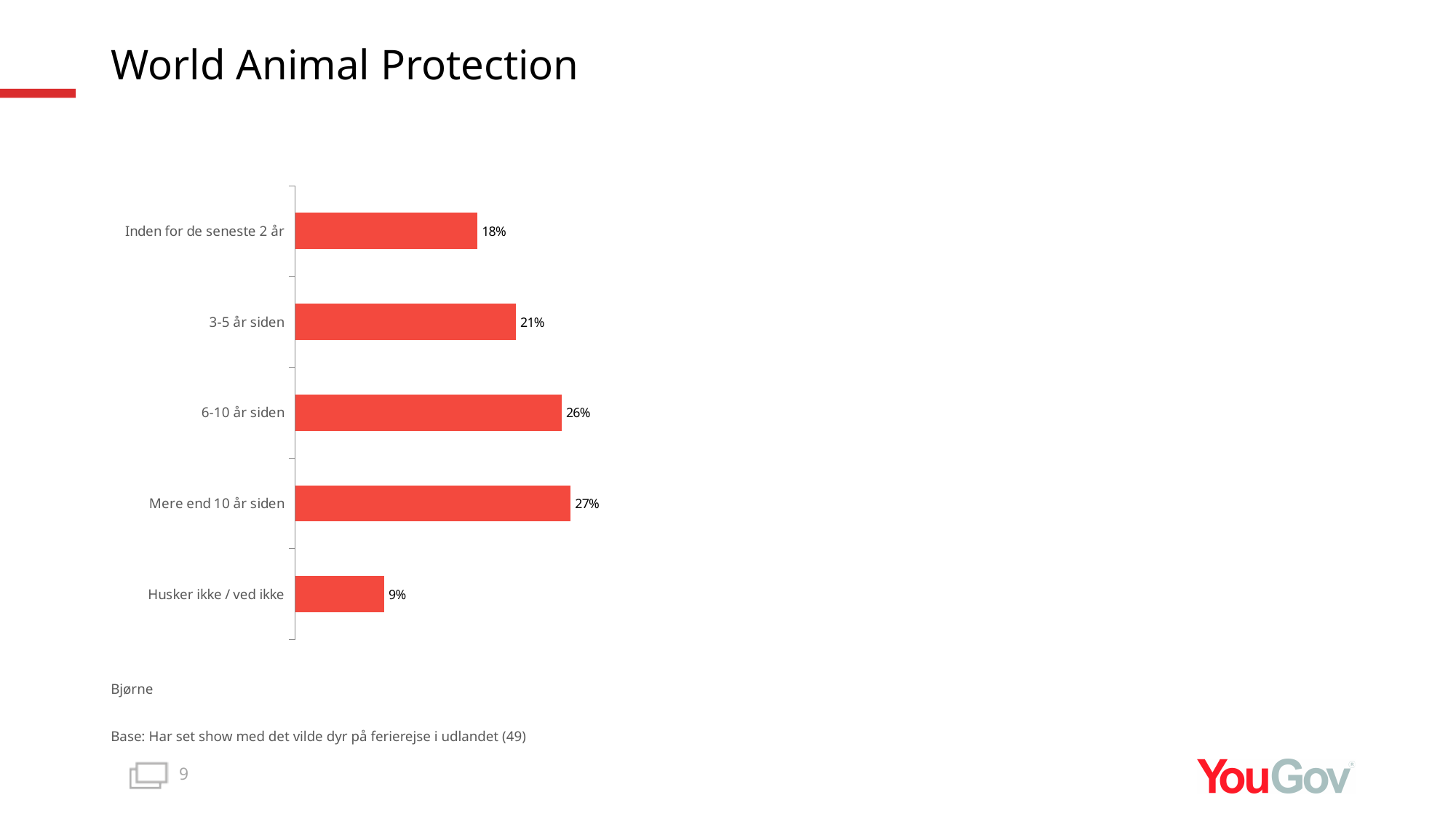
What is the value for "Husker ikke / ved ikke"? 9% What is the value for "Inden for de seneste 2 år"? 18% Which category has the highest value? Mere end 10 år siden What is the difference between "Mere end 10 år siden" and "Inden for de seneste 2 år"? 9 percentage points What is the value for "3-5 år siden"? 21% What is the value for "6-10 år siden"? 26% What colour are the bars in the chart? Red What is the difference between "6-10 år siden" and "Husker ikke / ved ikke"? 17 percentage points Which category has the lowest value? Husker ikke / ved ikke What kind of chart is shown on the slide? Bar chart Which is larger: "3-5 år siden" or "6-10 år siden"? 6-10 år siden How many categories are shown in the chart? 5